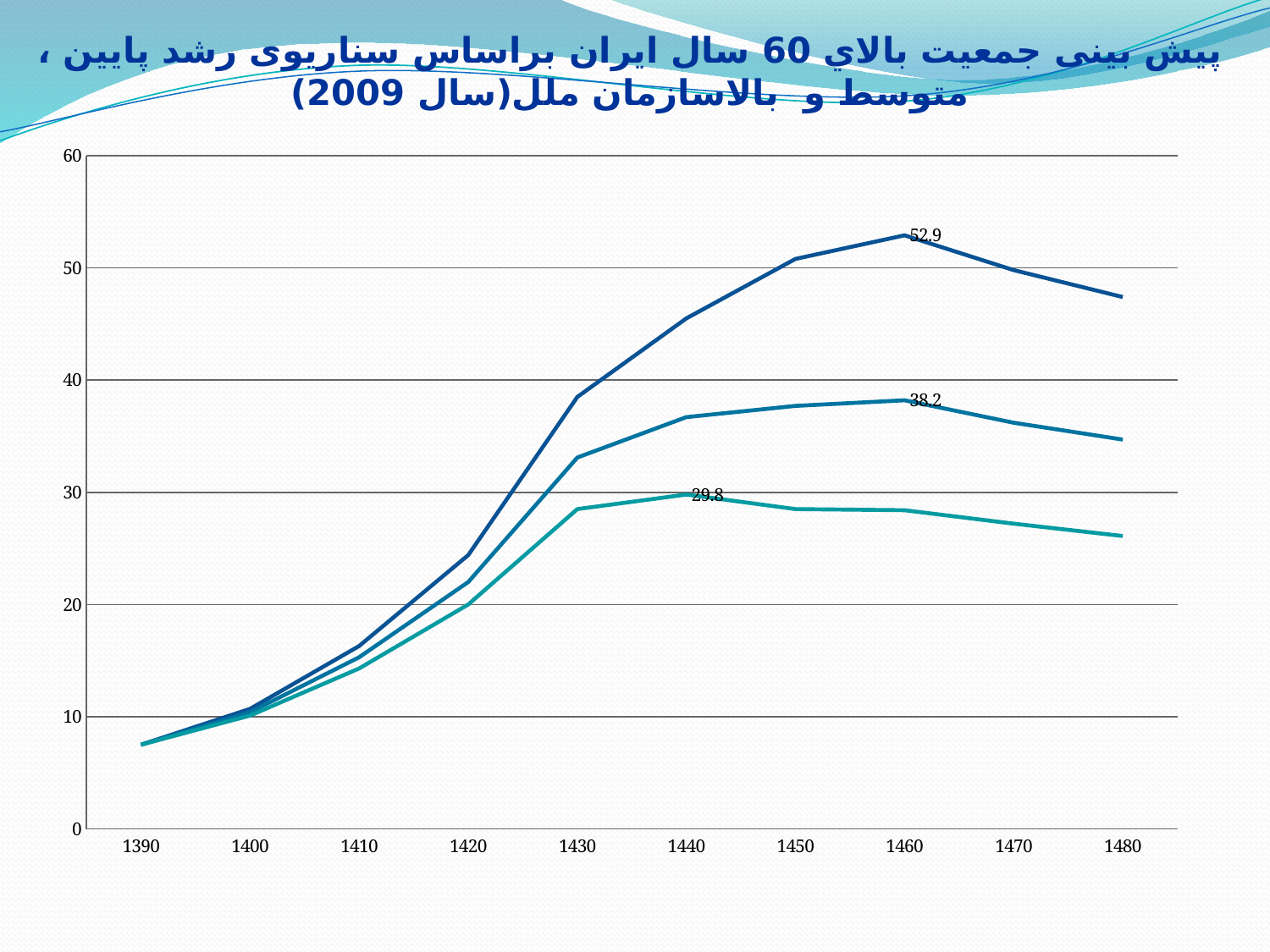
Is the value of the lines at 1390 greater or less than 10? less Is the value of the top line at 1480 greater or less than 40? greater What is the labelled value of the bottom line at 1440? 29.8 How many lines are plotted on the chart? 3 What is the difference between the labelled values of the top line and the middle line at 1460? 14.7 What is the labelled value of the middle line at 1460? 38.2 Does the top line rise or fall between 1390 and 1460? rises Is the value of the bottom line at 1480 greater or less than 30? less At 1460, which line has the larger labelled value, the top line or the middle line? the top line How many years are marked along the x axis of the chart? 10 What kind of chart is shown on the slide? line chart What is the labelled value of the top line at 1460? 52.9